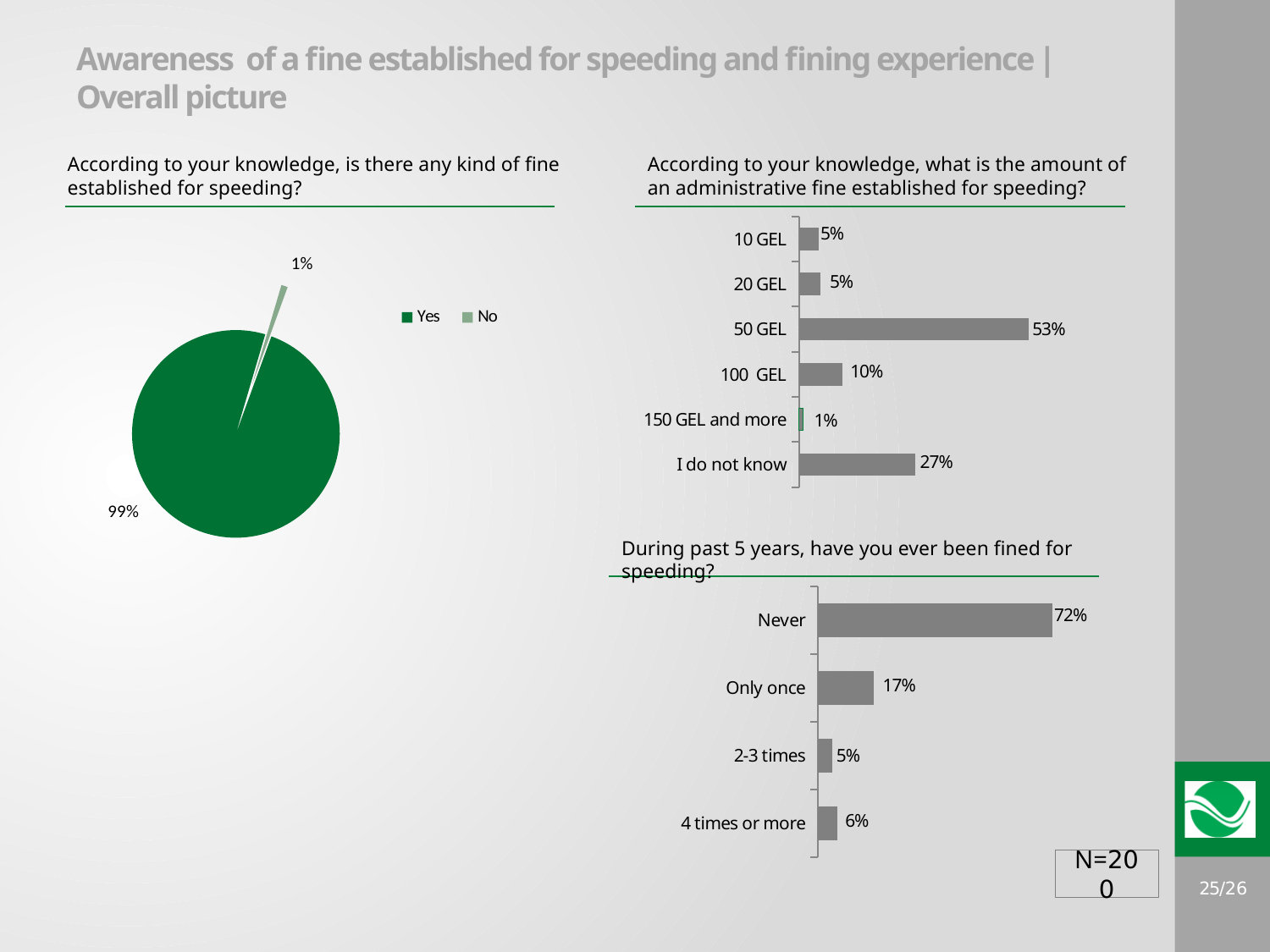
In the chart about being fined for speeding during the past 5 years, what is the value for Only once? 17% What kind of chart is the chart about being fined for speeding during the past 5 years? bar chart In the chart about being fined for speeding during the past 5 years, which is larger: the value for 2-3 times or the value for 4 times or more? 4 times or more In the chart about being fined for speeding during the past 5 years, which category has the highest value? Never In the chart about the amount of an administrative fine established for speeding, which category has the lowest value? 150 GEL and more In the chart about the amount of an administrative fine established for speeding, what is the value for 50 GEL? 53% What kind of chart is the chart on the left about whether a fine is established for speeding? pie chart In the chart about the amount of an administrative fine established for speeding, what is the difference between the values for 50 GEL and I do not know? 26% How many categories are shown in the chart about the amount of an administrative fine established for speeding? 6 In the pie chart on the left about whether a fine is established for speeding, what share of respondents answered Yes? 99% How many entries does the legend of the pie chart on the left list? 2 In the pie chart on the left about whether a fine is established for speeding, what share of respondents answered No? 1%